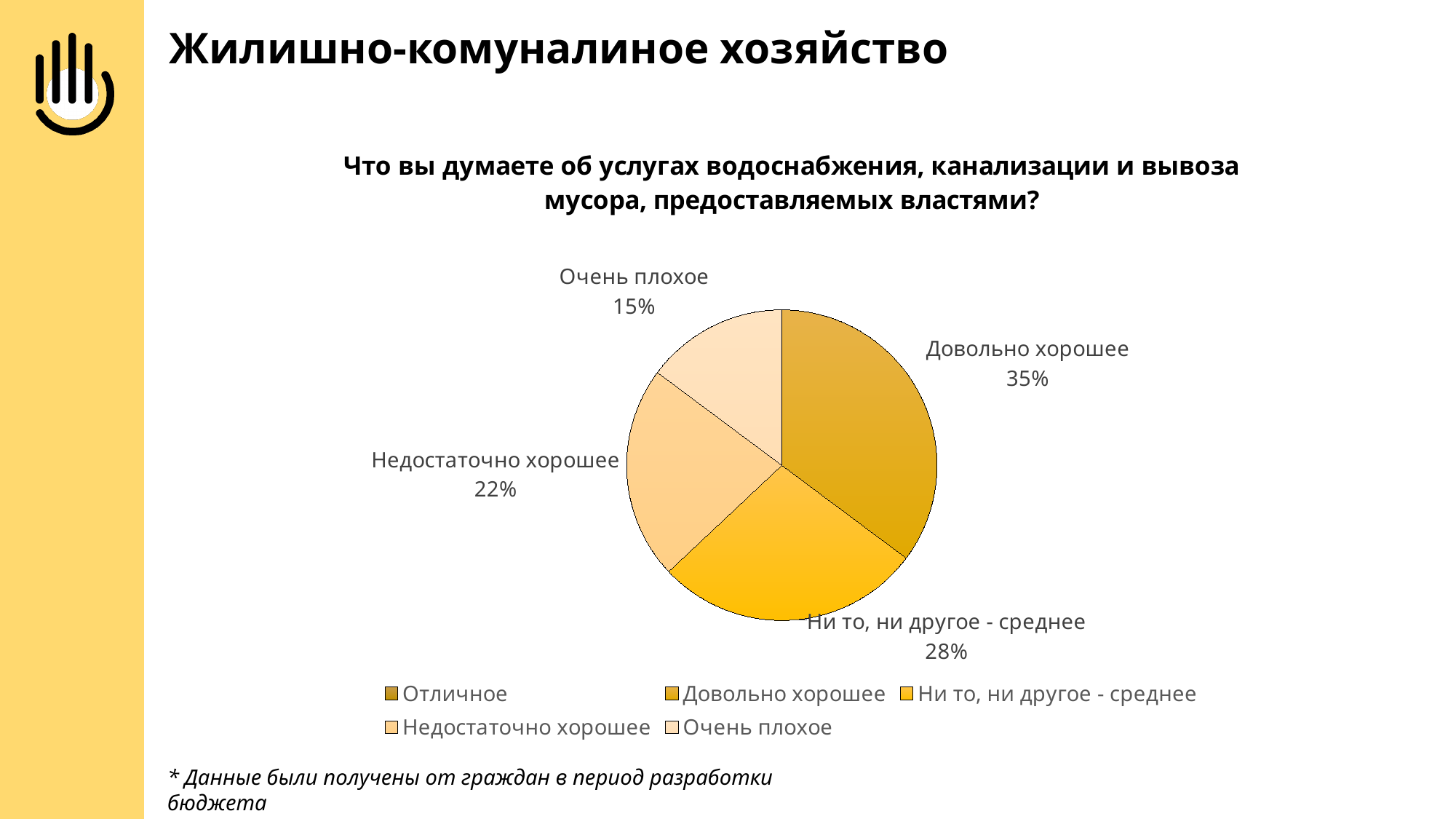
What percentage of respondents answered "Очень плохое"? 15% How many entries does the legend list? 5 Which labelled slice has the smallest share of the pie? Очень плохое Which legend entry does not appear as a labelled slice in the pie? Отличное How many slices with data labels are shown in the pie chart? 4 What is the difference in percentage points between "Довольно хорошее" and "Очень плохое"? 20 What percentage of respondents answered "Довольно хорошее"? 35% What percentage of respondents answered "Недостаточно хорошее"? 22% What percentage of respondents answered "Ни то, ни другое - среднее"? 28% Which response has the largest share of the pie? Довольно хорошее Which is larger: the share for "Ни то, ни другое - среднее" or the share for "Недостаточно хорошее"? Ни то, ни другое - среднее What type of chart is shown on the slide? pie chart